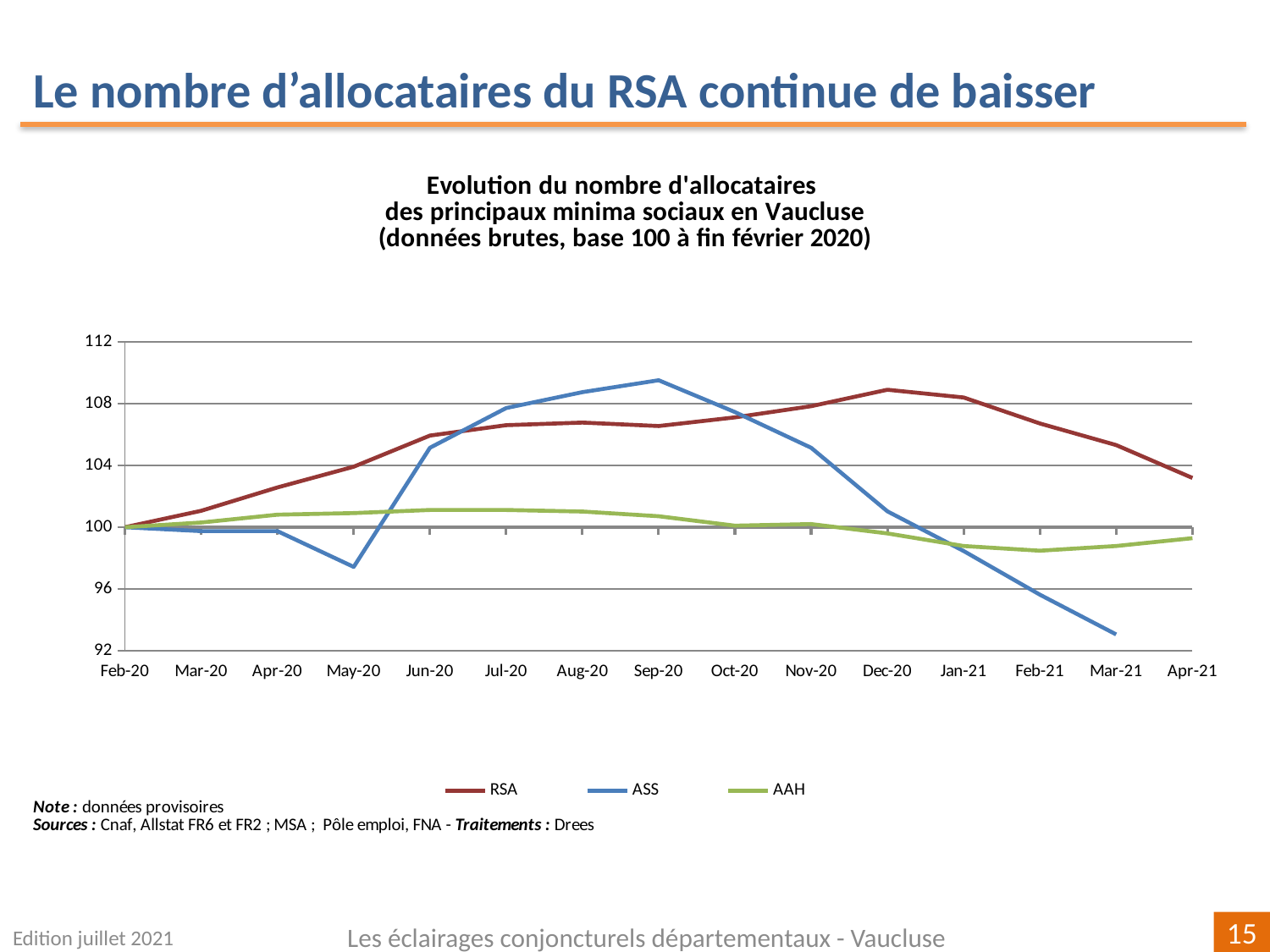
Does the RSA series rise or fall between Dec-20 and Apr-21? fall What is the value of the RSA series at Feb-20? 100 At Mar-21, which series has the higher value, RSA or ASS? RSA Is the value for ASS at Mar-21 greater or less than 96? less Is the value for ASS at May-20 greater or less than 100? less Is the value for AAH at Feb-21 greater or less than 100? less How many months are labelled on the x axis? 15 At Sep-20, which series has the higher value, RSA or ASS? ASS What kind of chart is shown on the slide? line chart Which series is shown in blue in the legend? ASS How many series does the legend list? 3